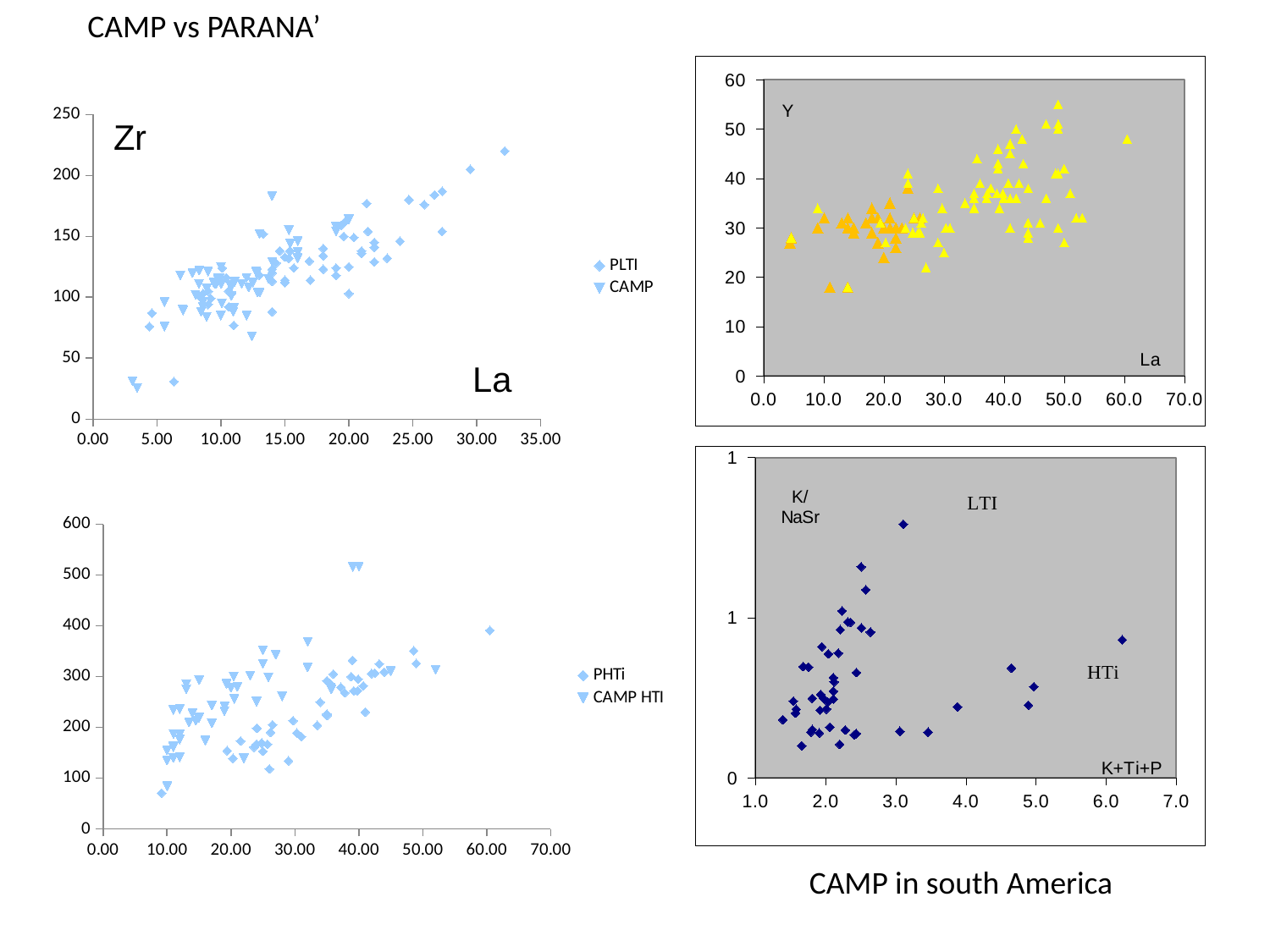
In the bottom-left chart, do the plotted values generally rise or fall as the x-axis value increases? rise In the top-left chart (Zr vs La), is the highest plotted Zr value greater or less than 200? greater How many series does the legend of the bottom-left chart list? 2 What kind of chart is the top-left chart (Zr vs La)? scatter chart How many series does the legend of the top-left chart (Zr vs La) list? 2 In the bottom-left chart, is the highest plotted value greater or less than 500? greater What kind of chart is the top-right chart (Y vs La)? scatter chart What are the two series named in the legend of the bottom-left chart? PHTi and CAMP HTI What are the two series named in the legend of the top-left chart (Zr vs La)? PLTI and CAMP In the top-right chart (Y vs La), is the highest plotted Y value greater or less than 50? greater In the top-left chart (Zr vs La), do Zr values generally rise or fall as La increases? rise In the top-right chart (Y vs La), do Y values generally rise or fall as La increases? rise